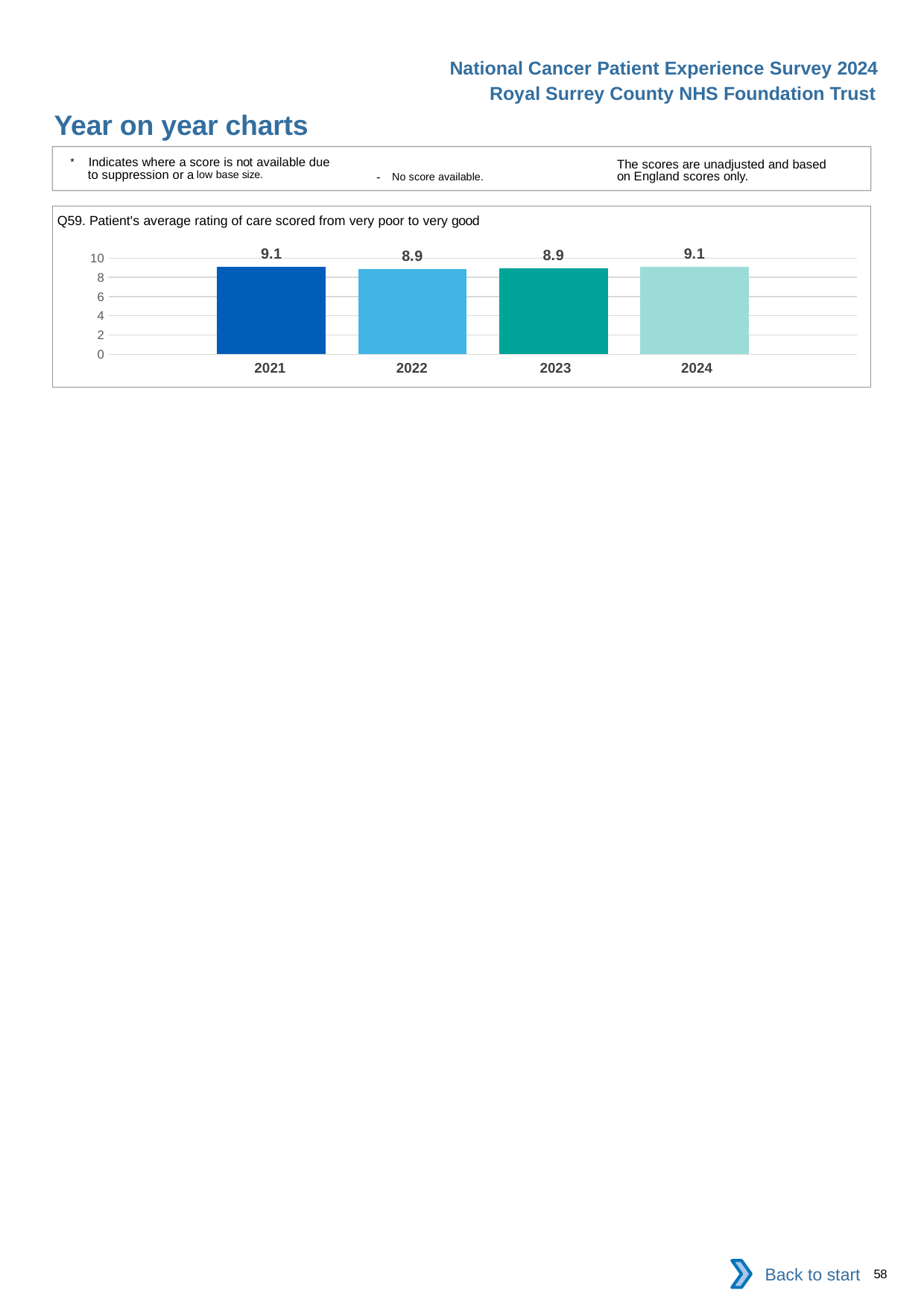
Which is larger, the value for 2022 or the value for 2024? 2024 What is the value for 2023? 8.9 Does the value rise or fall from 2023 to 2024? rise What is the difference between the values for 2021 and 2022? 0.2 Is the value for 2023 greater or less than 8? greater What is the value for 2021? 9.1 What is the value for 2024? 9.1 What is the difference between the values for 2024 and 2023? 0.2 What is the value for 2022? 8.9 What is the title of the chart? Q59. Patient's average rating of care scored from very poor to very good What kind of chart is shown? bar chart How many years are shown on the chart? 4